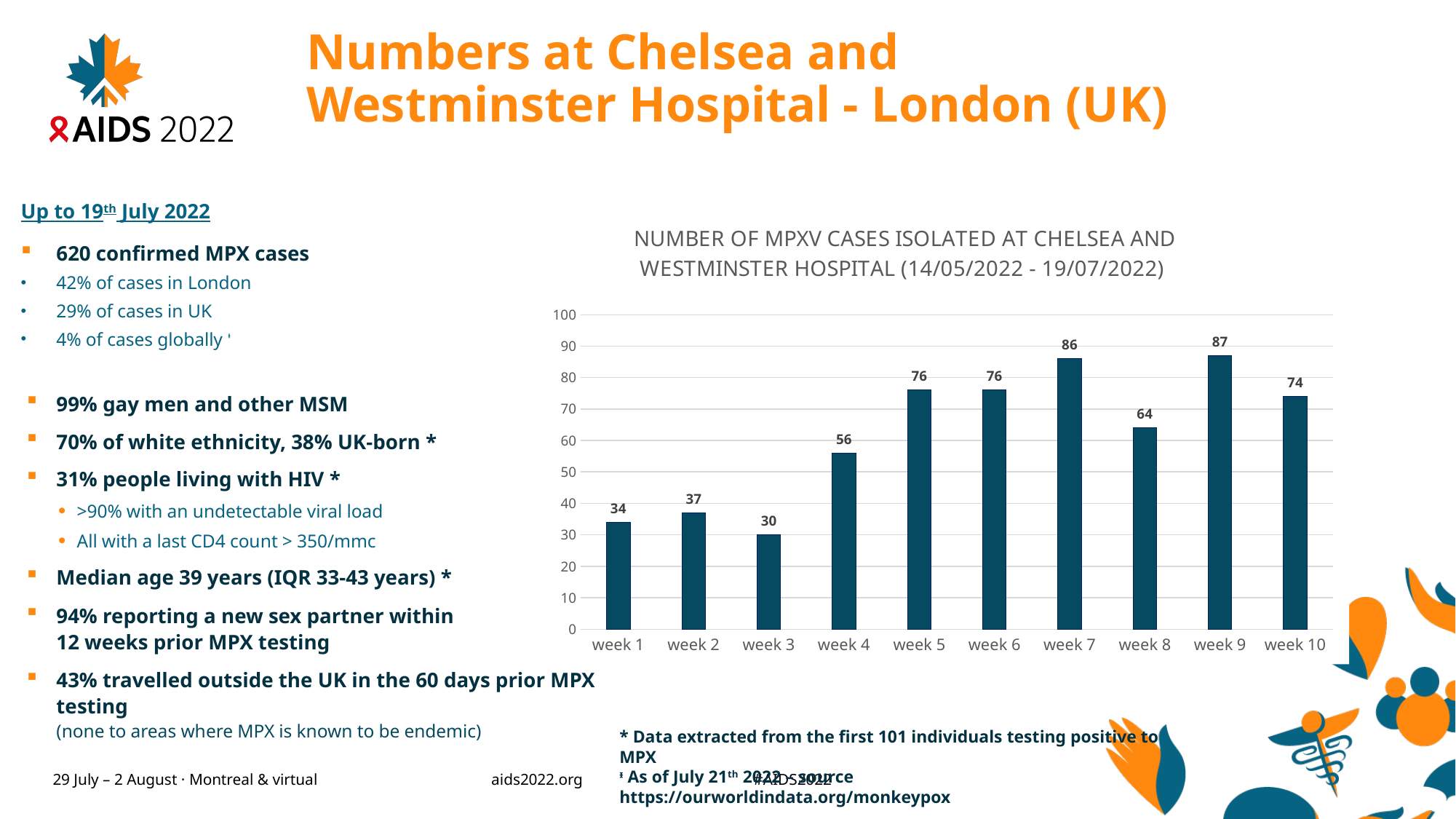
What is the number of MPXV cases isolated in week 8? 64 Is the value for week 7 greater or less than 80? greater What is the difference between the number of cases in week 9 and week 8? 23 Which week has more MPXV cases isolated, week 4 or week 10? week 10 Which week has the lowest number of MPXV cases isolated? week 3 How many weeks are shown on the x axis of the chart? 10 What is the number of MPXV cases isolated in week 1? 34 What date range is given in the chart title? 14/05/2022 - 19/07/2022 Which week has the highest number of MPXV cases isolated? week 9 What is the number of MPXV cases isolated in week 5? 76 What kind of chart is shown on the slide? bar chart Do the number of cases generally rise or fall from week 1 to week 9? rise